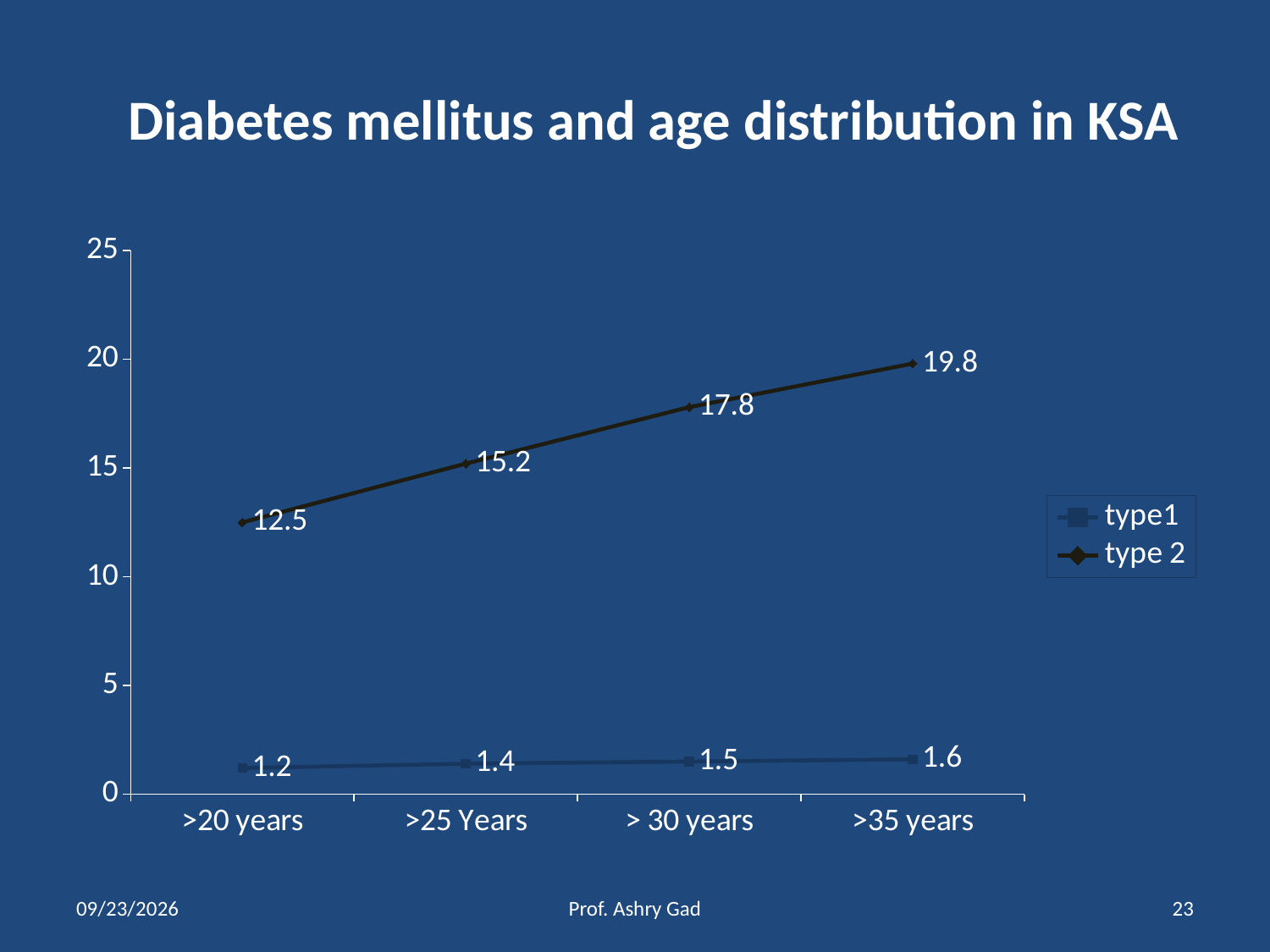
Which is larger: the type 2 value for > 30 years or the type 2 value for >25 Years? > 30 years Which age category has the lowest type1 value? >20 years What is the type 2 value for >20 years? 12.5 What is the type1 value for >35 years? 1.6 Is the type 2 value for > 30 years greater or less than 15? greater What is the difference between the type 2 values for >35 years and >20 years? 7.3 What kind of chart is shown on the slide? line chart What is the type 2 value for >25 Years? 15.2 Do the type 2 values rise or fall as age increases along the x axis? rise Which age category has the highest type 2 value? >35 years How many series does the legend list? 2 How many age categories are shown on the x axis? 4